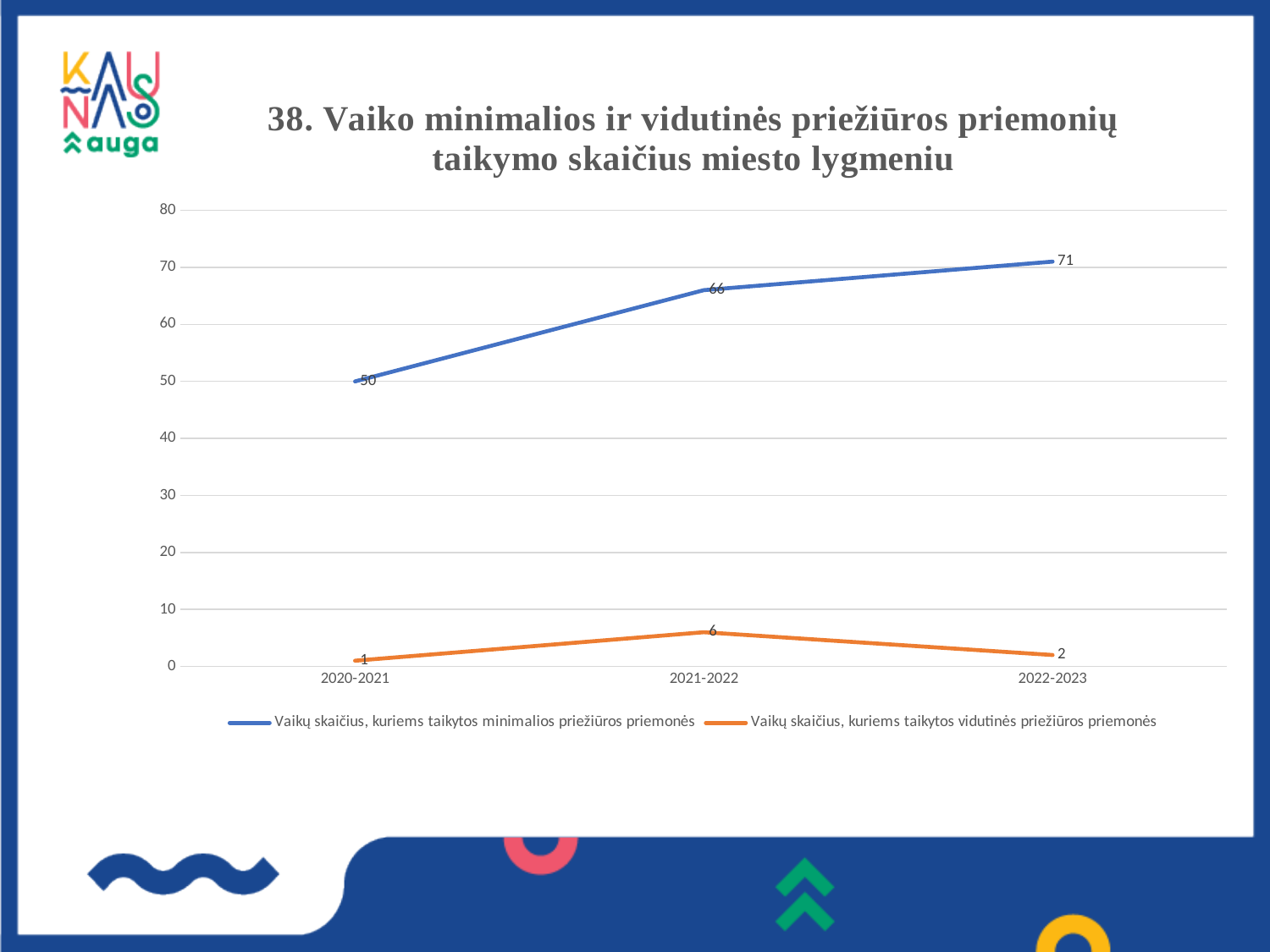
In which period is 'Vaikų skaičius, kuriems taikytos vidutinės priežiūros priemonės' lowest? 2020-2021 Is the 2021-2022 value for 'Vaikų skaičius, kuriems taikytos minimalios priežiūros priemonės' greater or less than 60? greater What is the value for 'Vaikų skaičius, kuriems taikytos vidutinės priežiūros priemonės' in 2021-2022? 6 What kind of chart is shown on the slide? line chart What is the difference between the 2022-2023 and 2020-2021 values for 'Vaikų skaičius, kuriems taikytos minimalios priežiūros priemonės'? 21 In which period is 'Vaikų skaičius, kuriems taikytos minimalios priežiūros priemonės' highest? 2022-2023 Which is larger in 2021-2022: the minimalios priežiūros series or the vidutinės priežiūros series? Vaikų skaičius, kuriems taikytos minimalios priežiūros priemonės What is the value for 'Vaikų skaičius, kuriems taikytos minimalios priežiūros priemonės' in 2022-2023? 71 How many periods are shown on the x axis? 3 How many series does the legend list? 2 What is the value for 'Vaikų skaičius, kuriems taikytos minimalios priežiūros priemonės' in 2020-2021? 50 Does 'Vaikų skaičius, kuriems taikytos minimalios priežiūros priemonės' rise or fall from 2020-2021 to 2022-2023? rise